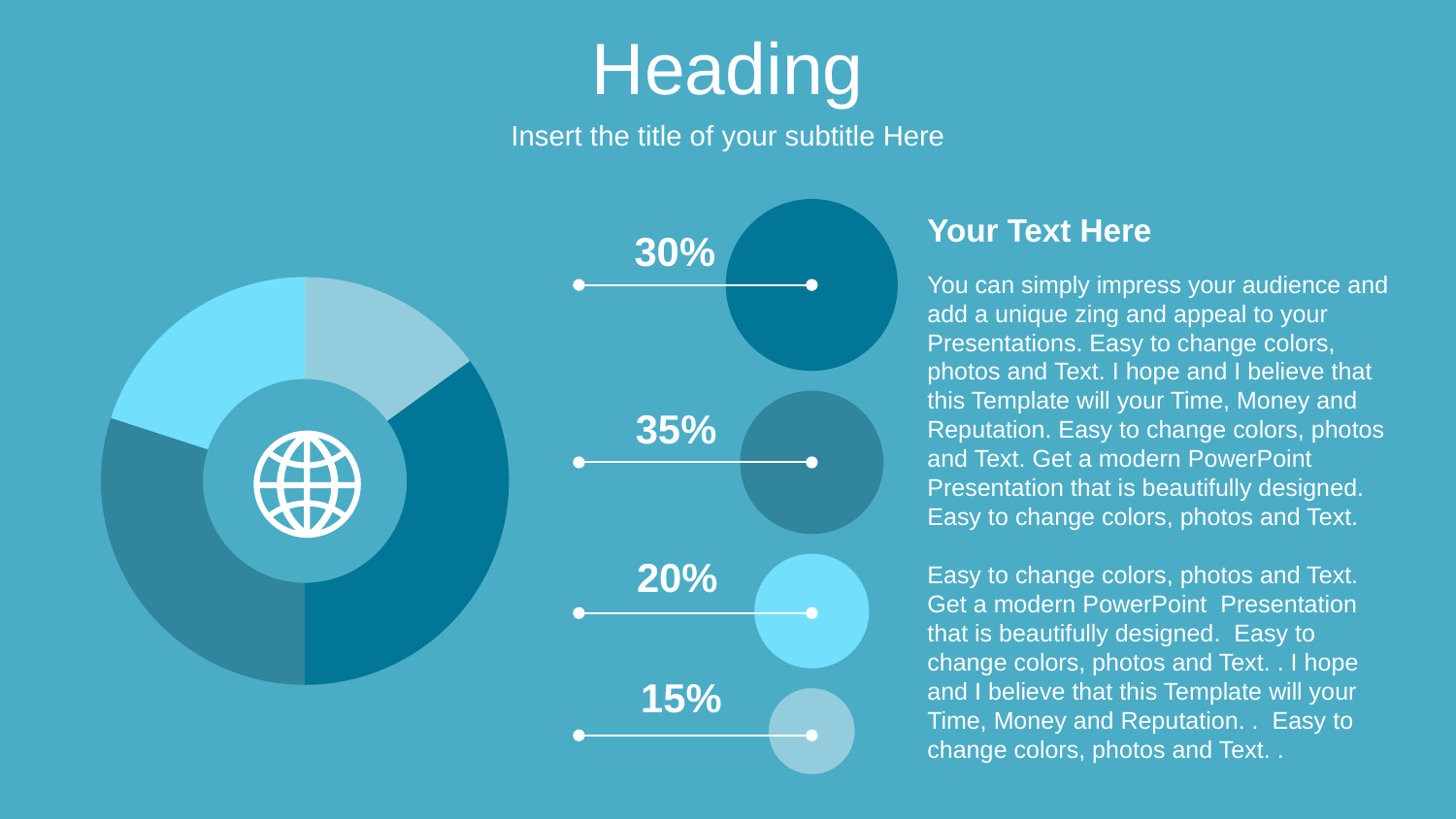
What is the largest percentage shown next to the circles? 35% What is the difference between the 35% value and the 15% value? 20% What is the smallest percentage shown next to the circles? 15% What percentage is shown for the darkest teal circle? 30% Which is larger, the value for the dark teal circle or the value for the light cyan circle? Dark teal circle (30%) What is the difference between the 30% value and the 20% value? 10% How many slices does the donut chart have? 4 What percentage is shown for the pale blue circle at the bottom? 15% What do the four percentages shown on the slide add up to? 100% What icon is shown in the centre of the donut chart? A globe What kind of chart is shown on the left of the slide? Pie chart (donut) What percentage is shown for the light cyan circle? 20%